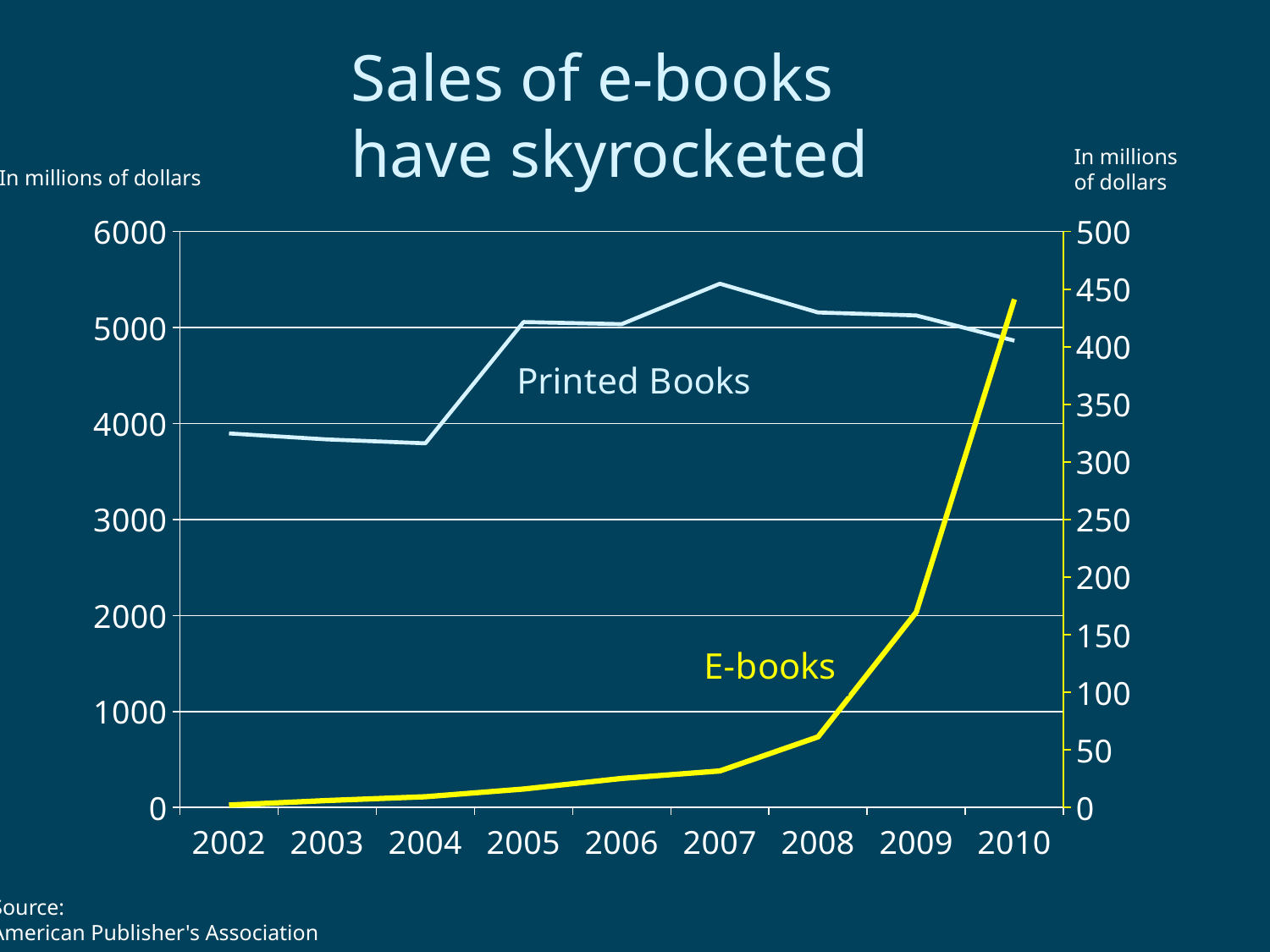
Is the value for Printed Books in 2007 greater or less than 5000? greater Which series is drawn in yellow? E-books In which year are E-books sales lowest? 2002 In which year are Printed Books sales highest? 2007 Do E-books sales rise or fall from 2002 to 2010? rise How many years are plotted along the x axis? 9 In which year are E-books sales highest? 2010 What is the title of the chart? Sales of e-books have skyrocketed How many data series are plotted on the chart? 2 Is the value for E-books in 2010 greater or less than 400? greater Which is larger, Printed Books sales in 2007 or in 2010? 2007 What kind of chart is shown on the slide? line chart